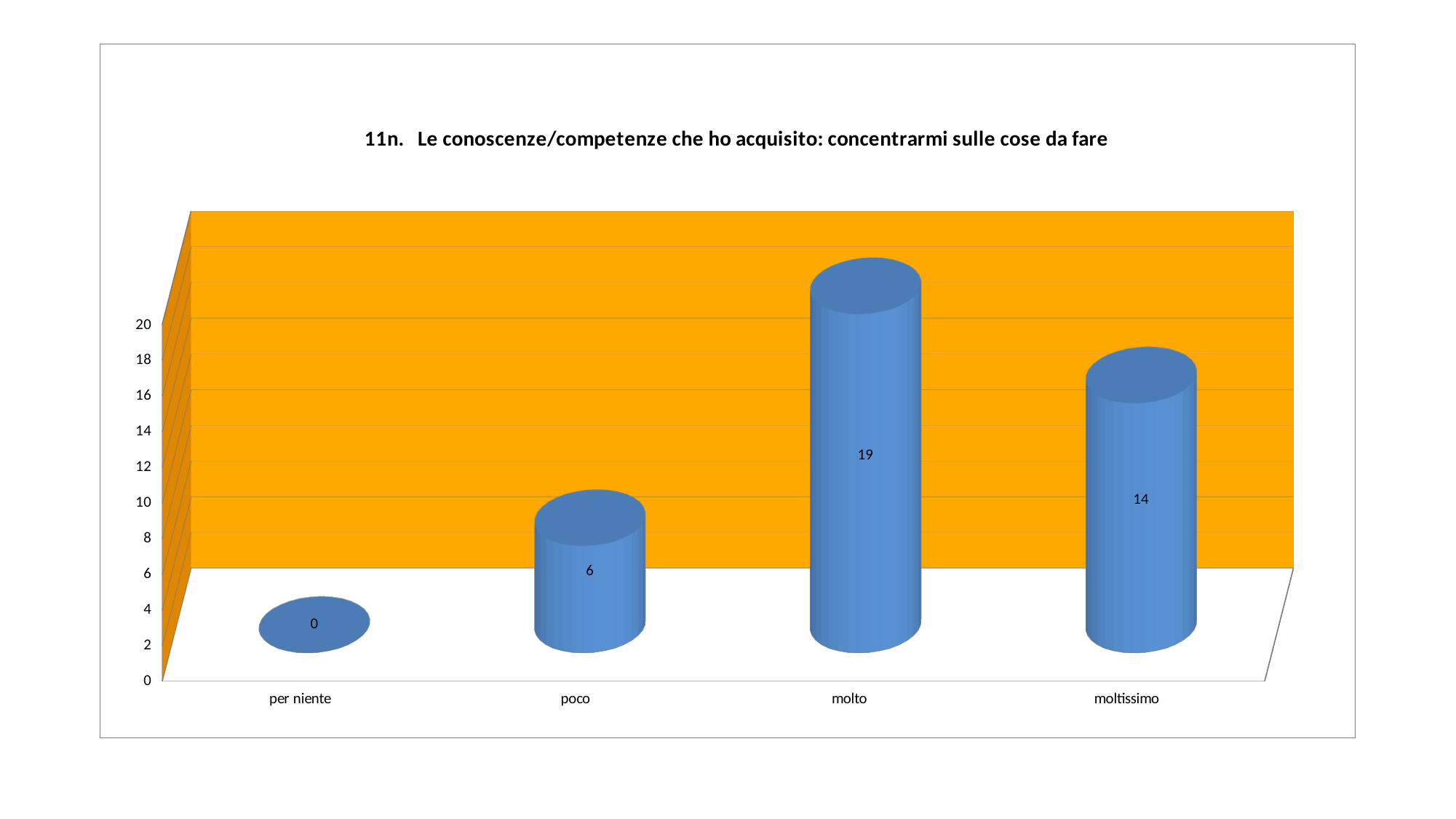
What is the value for "per niente"? 0 What is the difference between the values for "moltissimo" and "poco"? 8 Which is larger, the value for "poco" or the value for "moltissimo"? moltissimo What is the value for "molto"? 19 What is the value for "moltissimo"? 14 What kind of chart is shown on the slide? bar chart What is the difference between the values for "molto" and "moltissimo"? 5 How many categories are shown on the x axis? 4 Which category has the highest value? molto What is the value for "poco"? 6 Which category has the lowest value? per niente What is the title of the chart? 11n. Le conoscenze/competenze che ho acquisito: concentrarmi sulle cose da fare